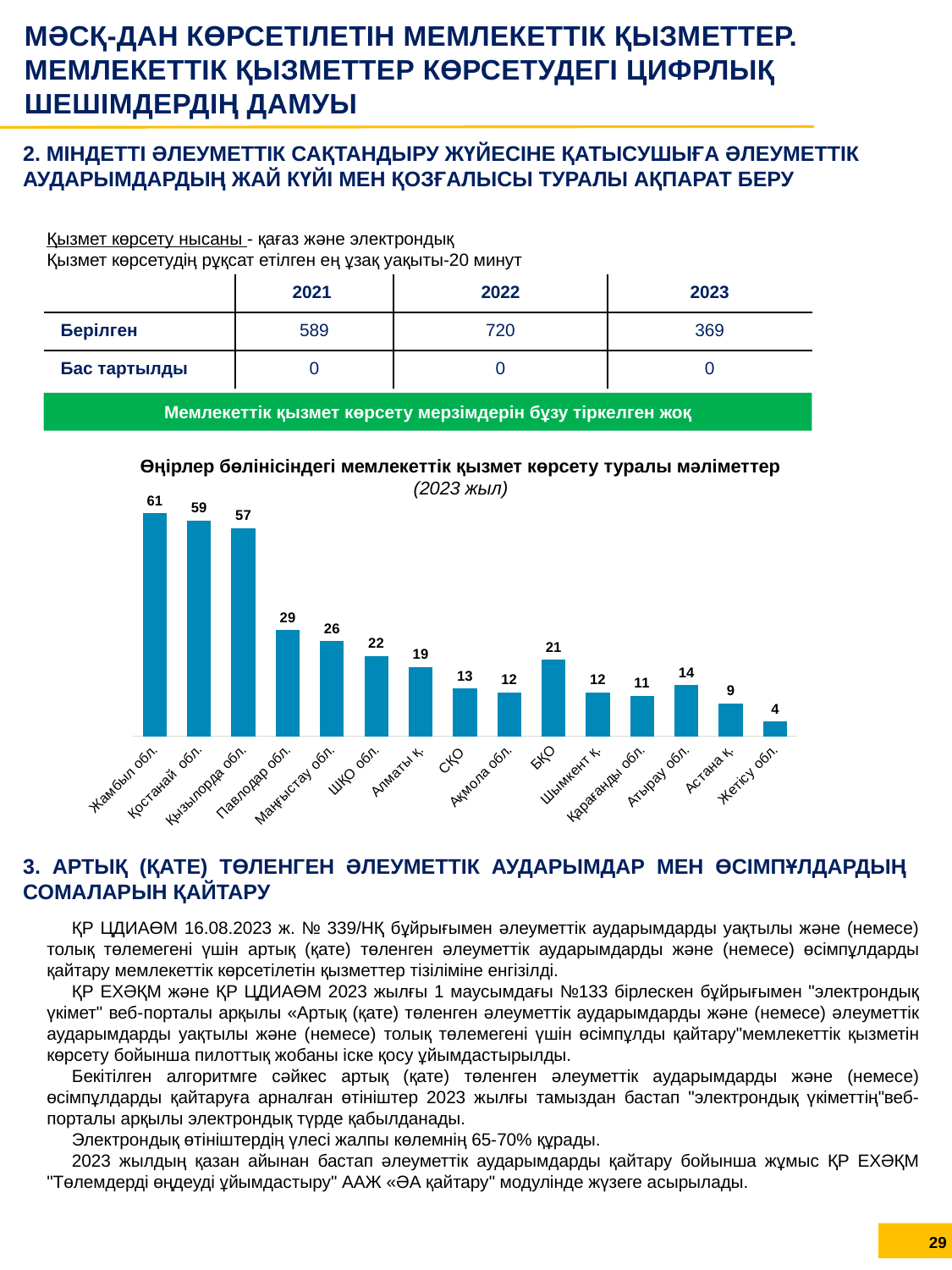
What is the value for Жамбыл обл. in the chart? 61 Which has a larger value, Атырау обл. or Қарағанды обл.? Атырау обл. What type of chart is shown on the slide? Bar chart What is the value for Астана қ. in the chart? 9 Which has a larger value, Маңғыстау обл. or ШҚО? Маңғыстау обл. What is the difference between the values for Жамбыл обл. and Қостанай обл.? 2 Which region has the highest value in the chart? Жамбыл обл. What is the value for Павлодар обл. in the chart? 29 What is the difference between the values for Қызылорда обл. and Павлодар обл.? 28 Which region has the lowest value in the chart? Жетісу обл. How many regions are shown in the chart? 15 What is the value for БҚО in the chart? 21